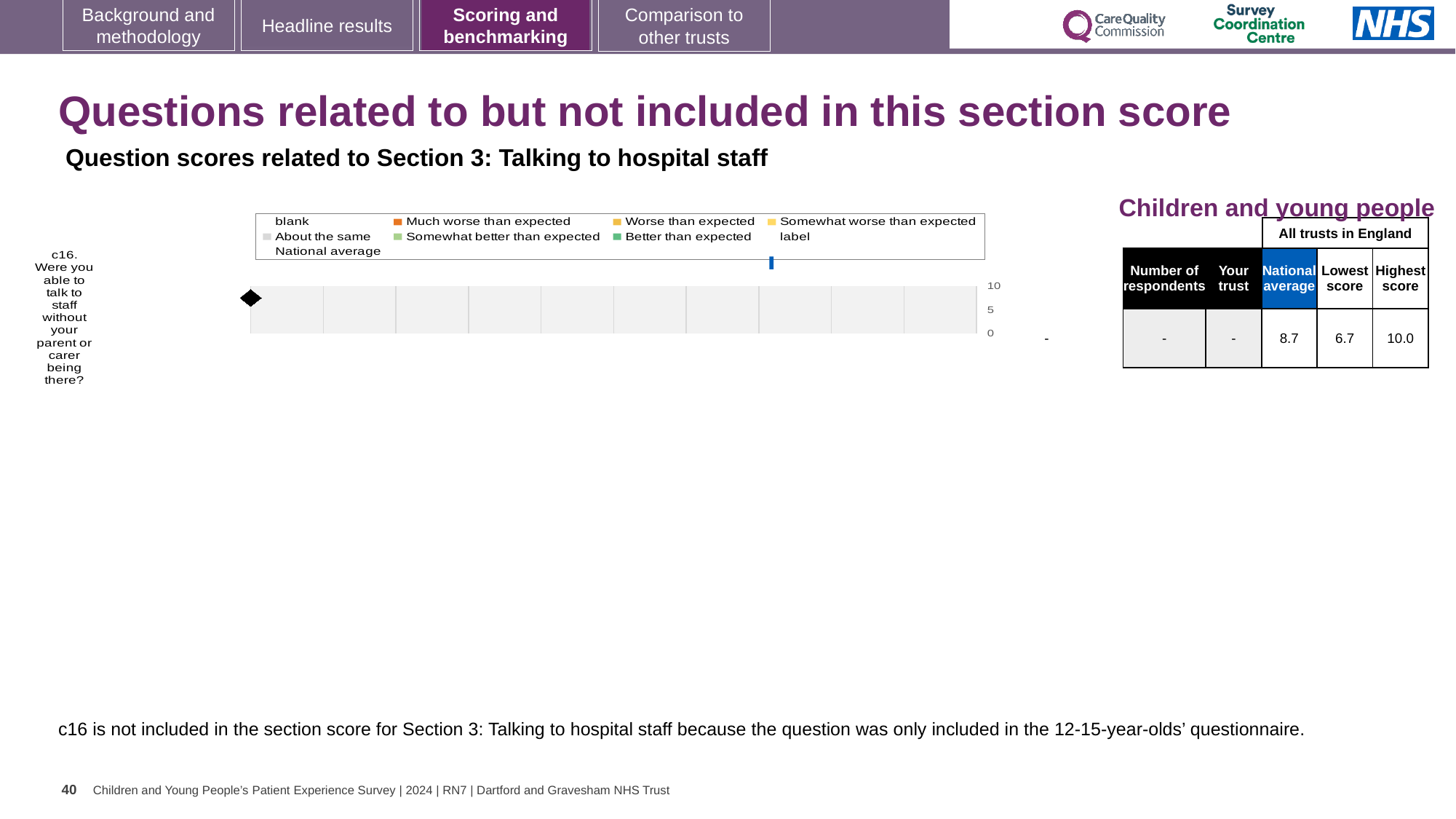
In the table next to the chart, which is larger for c16: the national average or the lowest score? national average How many question categories are shown on the chart's vertical axis? 1 In the table next to the chart, what is the difference between the highest score and the lowest score for c16? 3.3 What kind of chart is shown on the slide? bar chart Which question is listed on the chart's vertical axis? c16. Were you able to talk to staff without your parent or carer being there? How many entries does the chart's legend list? 9 In the table next to the chart, what is the highest score across all trusts in England for c16? 10.0 In the table next to the chart, what is the national average score for c16? 8.7 In the table next to the chart, what is the lowest score across all trusts in England for c16? 6.7 What is the highest tick value shown on the chart's horizontal axis? 10